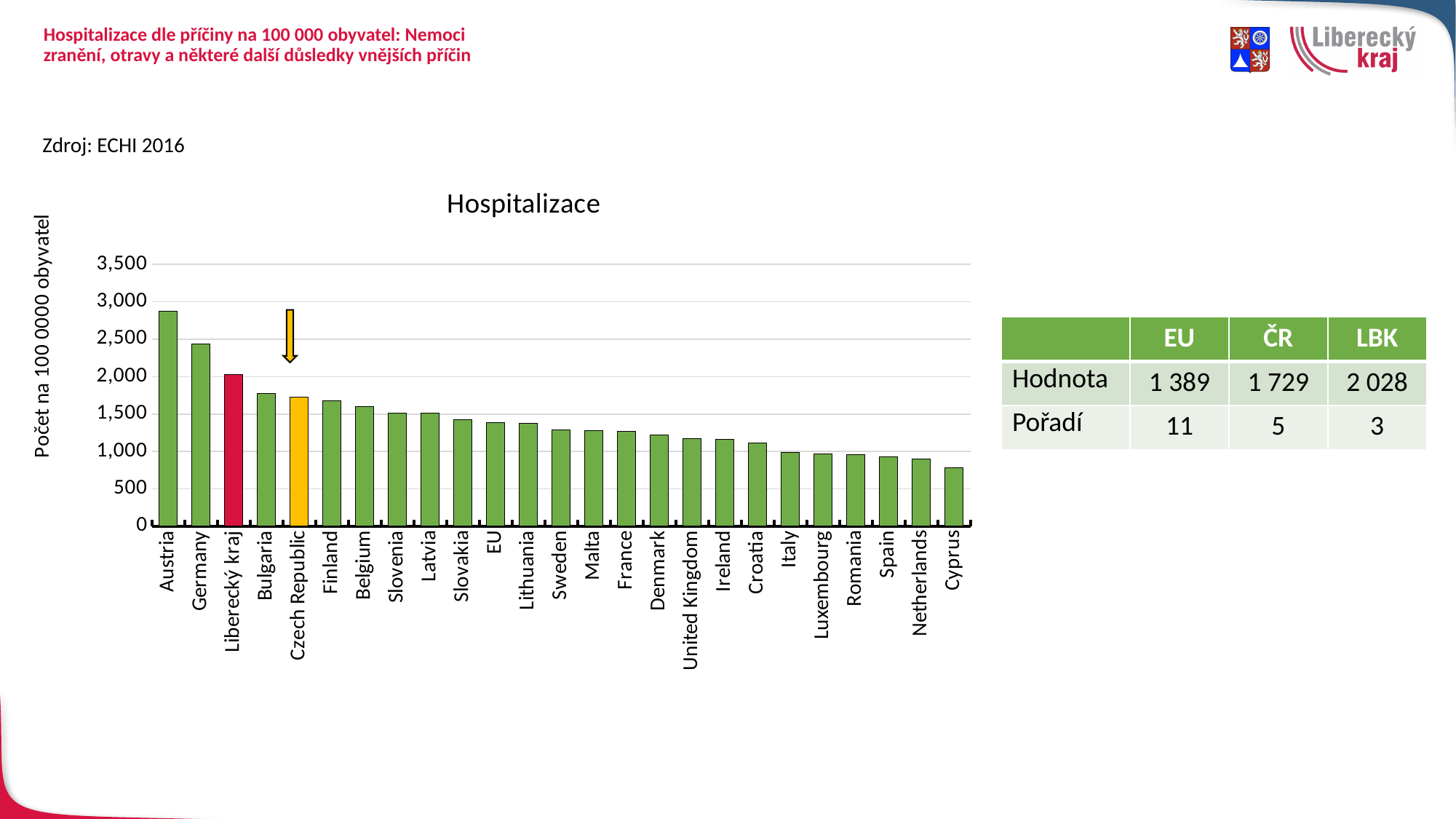
What is the hospitalization value for the EU according to the table? 1 389 Is the value for Cyprus greater or less than 1,000? less How many categories (countries/regions) are plotted in the chart? 25 Which has a higher value, Austria or Germany? Austria Which country or region has the highest hospitalization rate in the chart? Austria Which country has the lowest hospitalization rate in the chart? Cyprus What kind of chart is shown on the slide? bar chart What is the difference between the values for LBK and ČR shown in the table? 299 What is the hospitalization value for the Czech Republic (ČR) according to the table? 1 729 Is the value for Austria greater or less than 2,500? greater Do the values rise or fall from left to right along the x axis? fall What is the hospitalization value for Liberecký kraj (LBK) according to the table? 2 028